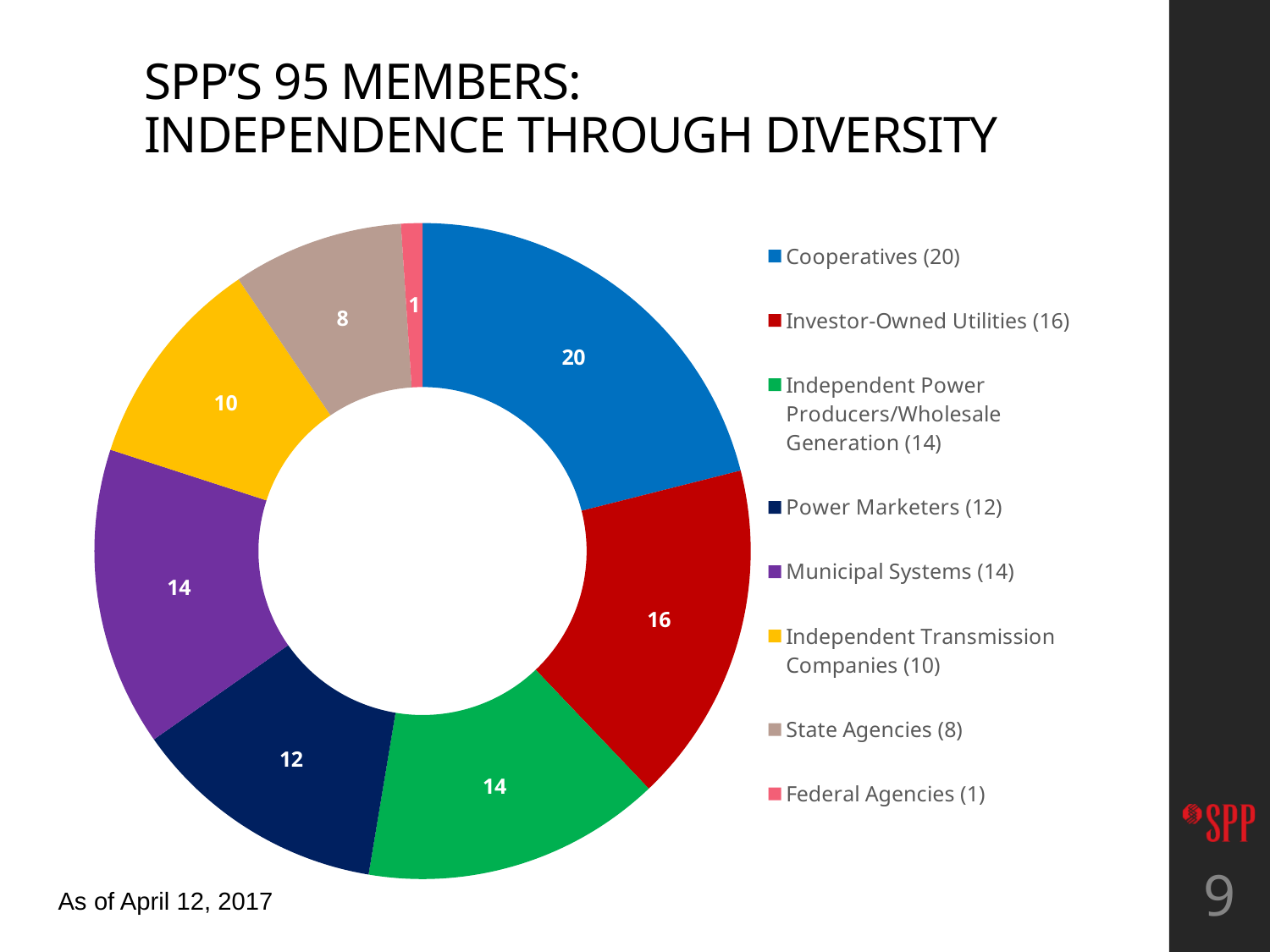
Which category has the smallest number of members? Federal Agencies (1) How many members are Cooperatives? 20 What is the difference between Independent Transmission Companies and State Agencies? 2 What kind of chart is shown on the slide? Pie (donut) chart What is the value shown for Power Marketers? 12 How many members are State Agencies? 8 Which category has the largest number of members? Cooperatives (20) Which is larger, Municipal Systems or Power Marketers? Municipal Systems What is the difference between the number of Cooperatives and the number of Investor-Owned Utilities? 4 How many categories does the chart show? 8 What colour is the Investor-Owned Utilities slice? Red What is the total number of members across all categories in the chart? 95